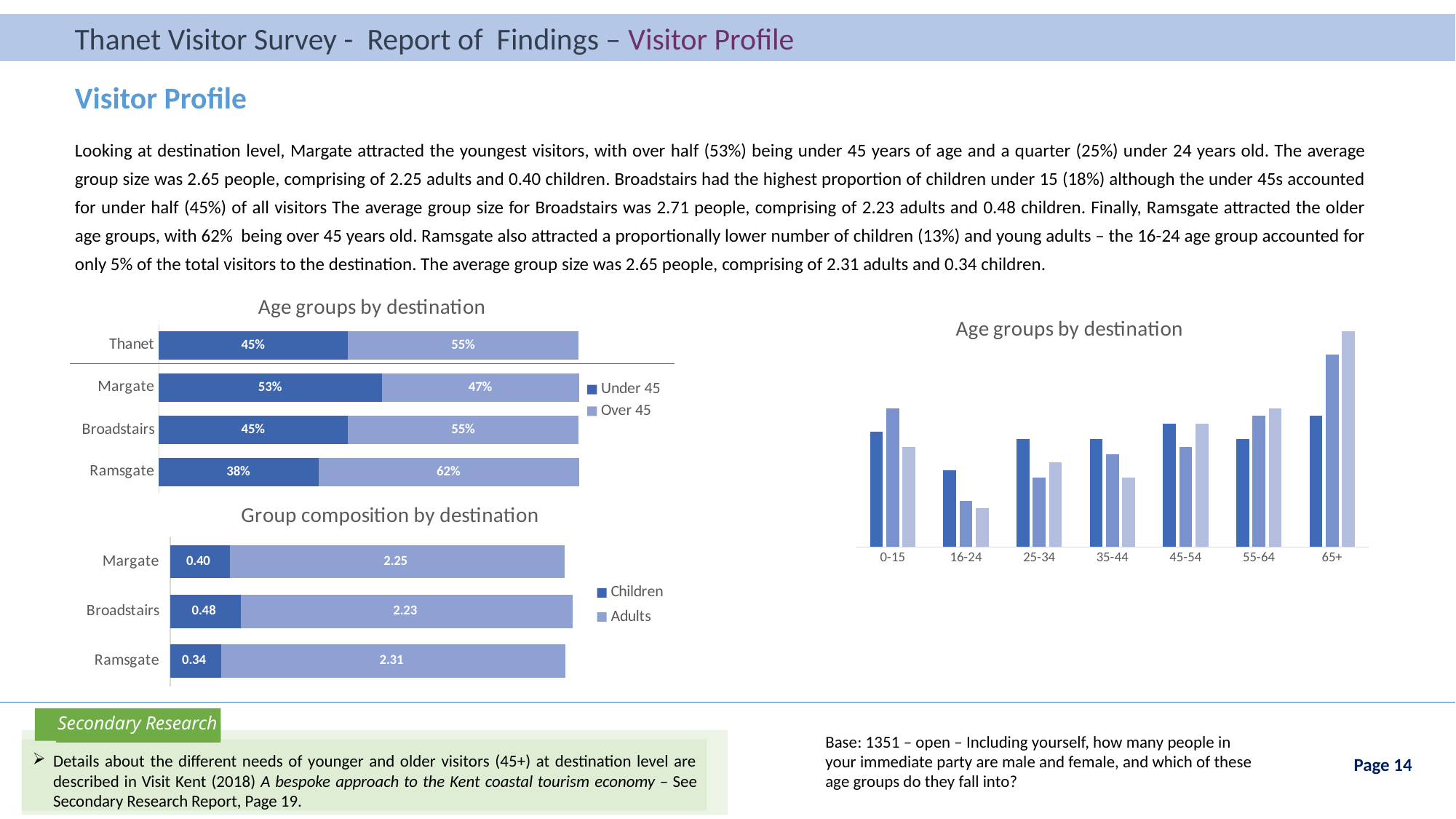
In the 'Age groups by destination' stacked bar chart on the left, what percentage of Ramsgate visitors are Over 45? 62% In the 'Age groups by destination' stacked bar chart on the left, which destination has the lowest Under 45 share? Ramsgate In the 'Group composition by destination' chart, what is the average number of children per group for Broadstairs? 0.48 What kind of chart is the 'Age groups by destination' chart on the right of the slide? Bar chart In the 'Group composition by destination' chart, what is the total average group size for Broadstairs (children plus adults)? 2.71 In the 'Age groups by destination' clustered bar chart on the right, how many age group categories are shown on the x axis? 7 In the 'Age groups by destination' stacked bar chart on the left, what percentage of Margate visitors are Under 45? 53% In the 'Age groups by destination' stacked bar chart on the left, what is the difference between the Over 45 share for Ramsgate and for Margate? 15% In the 'Group composition by destination' chart, what is the average number of adults per group for Ramsgate? 2.31 In the 'Age groups by destination' stacked bar chart on the left, which destination has the highest Under 45 share? Margate In the 'Age groups by destination' stacked bar chart on the left, how many series does the legend list? 2 In the 'Group composition by destination' chart, which destination has the lowest Children value? Ramsgate